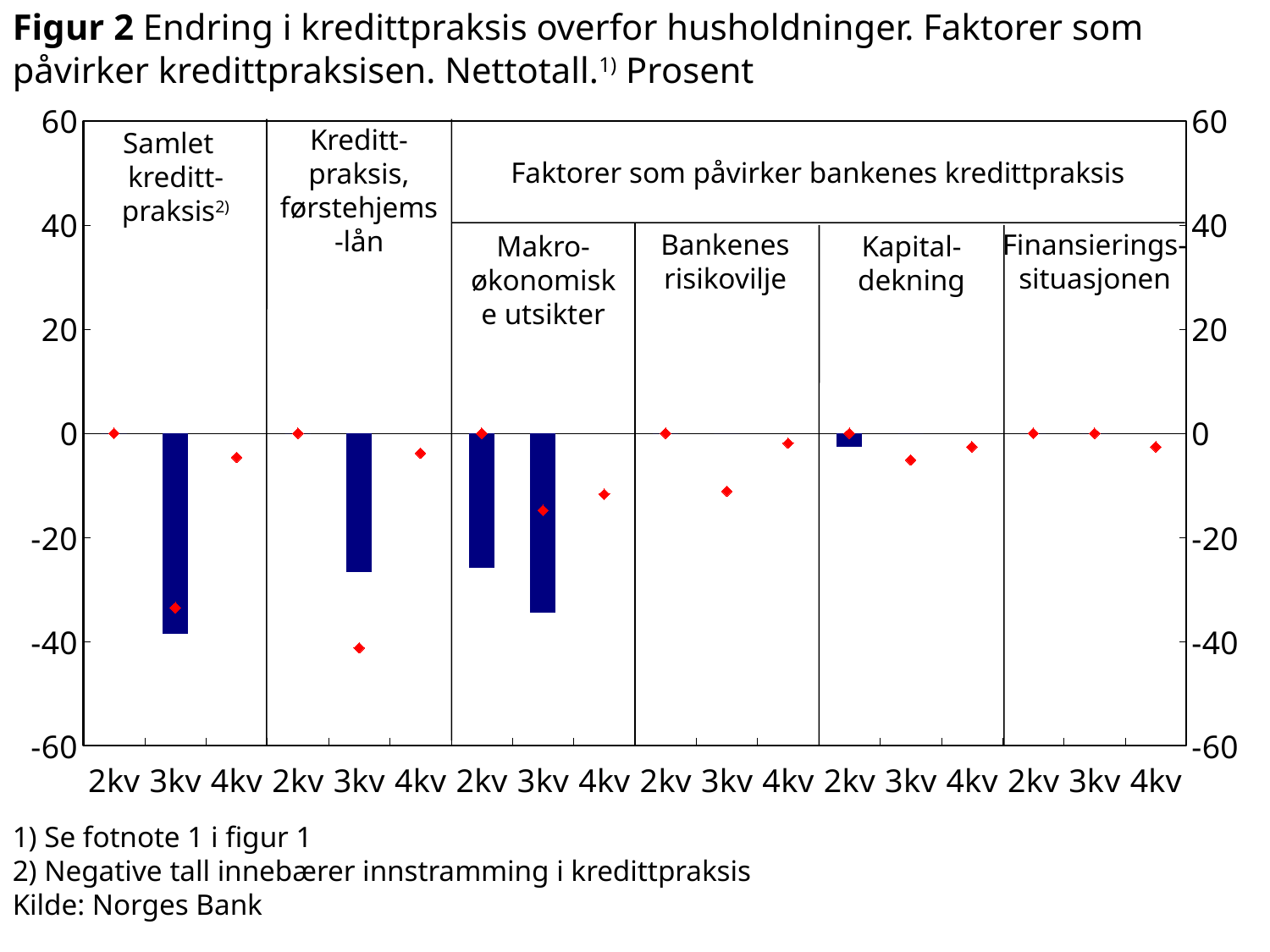
What kind of chart is shown in Figur 2? bar chart In the 'Makroøkonomiske utsikter' panel, which bar is lower: 2kv or 3kv? 3kv Which bar is lower: 3kv in 'Samlet kredittpraksis' or 3kv in 'Kredittpraksis, førstehjemslån'? 3kv in Samlet kredittpraksis Which panel contains the lowest (most negative) bar in the chart? Samlet kredittpraksis Is the bar for 3kv in the 'Kredittpraksis, førstehjemslån' panel greater or less than -40? greater Is the bar for 3kv in the 'Samlet kredittpraksis' panel greater or less than -20? less How many quarter labels (2kv, 3kv, 4kv) appear along the x axis in total? 18 What is the maximum value shown on the vertical axis? 60 Is the bar for 2kv in the 'Makroøkonomiske utsikter' panel greater or less than -20? less How many panels (factor groups) are shown along the x axis of the chart? 6 What colour are the bars in the chart? dark blue